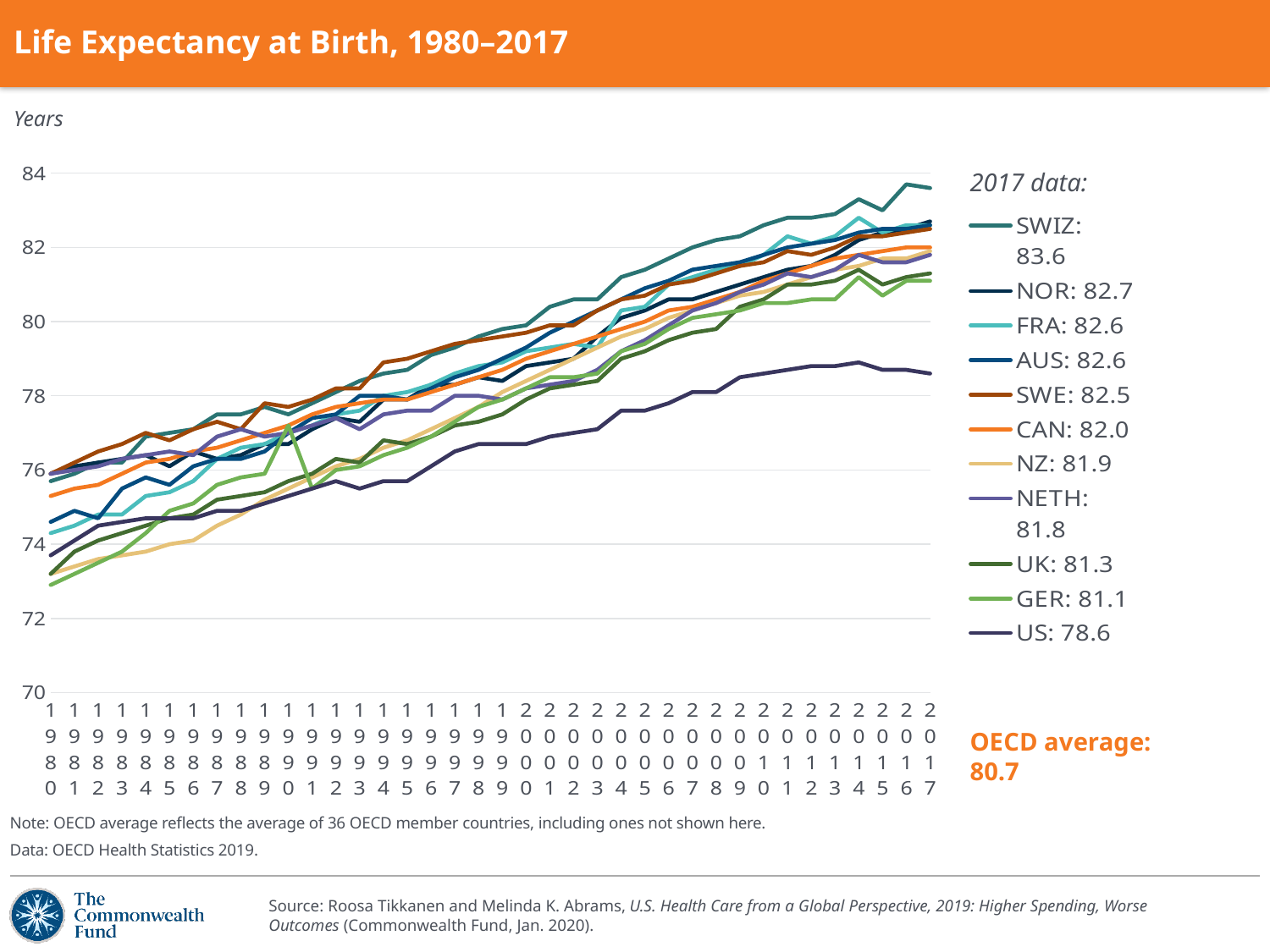
Do the life expectancy values generally rise or fall from 1980 to 2017? rise How many countries are listed in the legend? 11 Which country has the highest life expectancy in 2017? SWIZ What OECD average value is shown on the slide? 80.7 What kind of chart is shown on the slide? line chart Which has a higher 2017 life expectancy, NOR or FRA? NOR Is the value for GER in 1980 greater or less than 74? less Which country has the lowest life expectancy in 2017? US What is the 2017 life expectancy value shown for the US? 78.6 What is the 2017 life expectancy value shown for CAN? 82.0 What is the difference between the 2017 life expectancy of SWIZ and the US? 5.0 What is the 2017 life expectancy value shown for SWIZ? 83.6